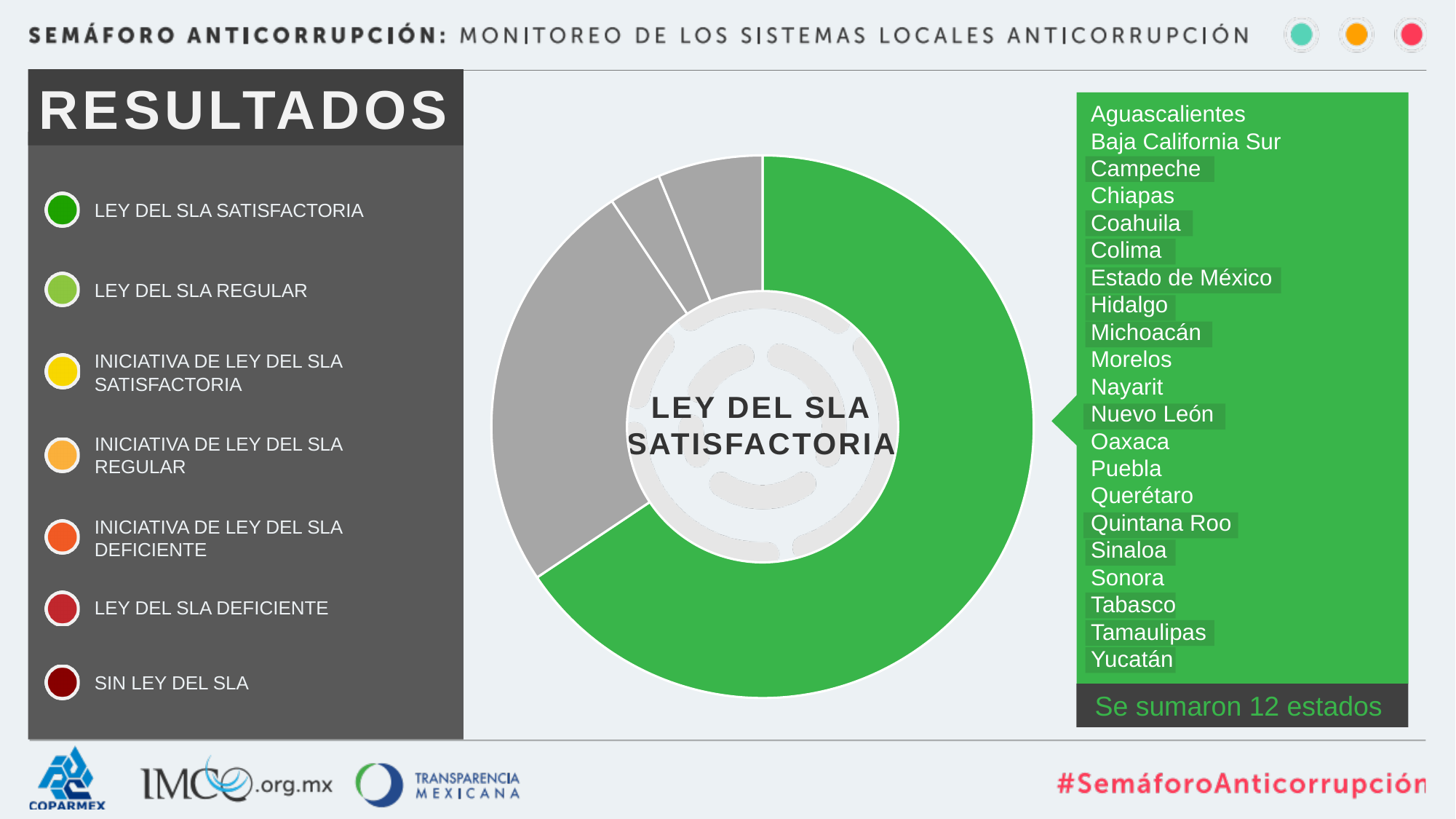
What kind of chart is shown on the slide? Pie chart (donut) According to the note below the list of states, how many states were added? 12 estados What colour are the slices of the chart that are not highlighted? Grey How many states are listed in the green box next to the chart? 21 How many categories does the legend on the left list? 7 Is the green slice larger or smaller than the largest grey slice? Larger Which category does the highlighted green slice of the chart represent? LEY DEL SLA SATISFACTORIA How many slices does the chart have? 4 What text is written in the centre of the donut chart? LEY DEL SLA SATISFACTORIA Which slice of the chart is the largest? LEY DEL SLA SATISFACTORIA